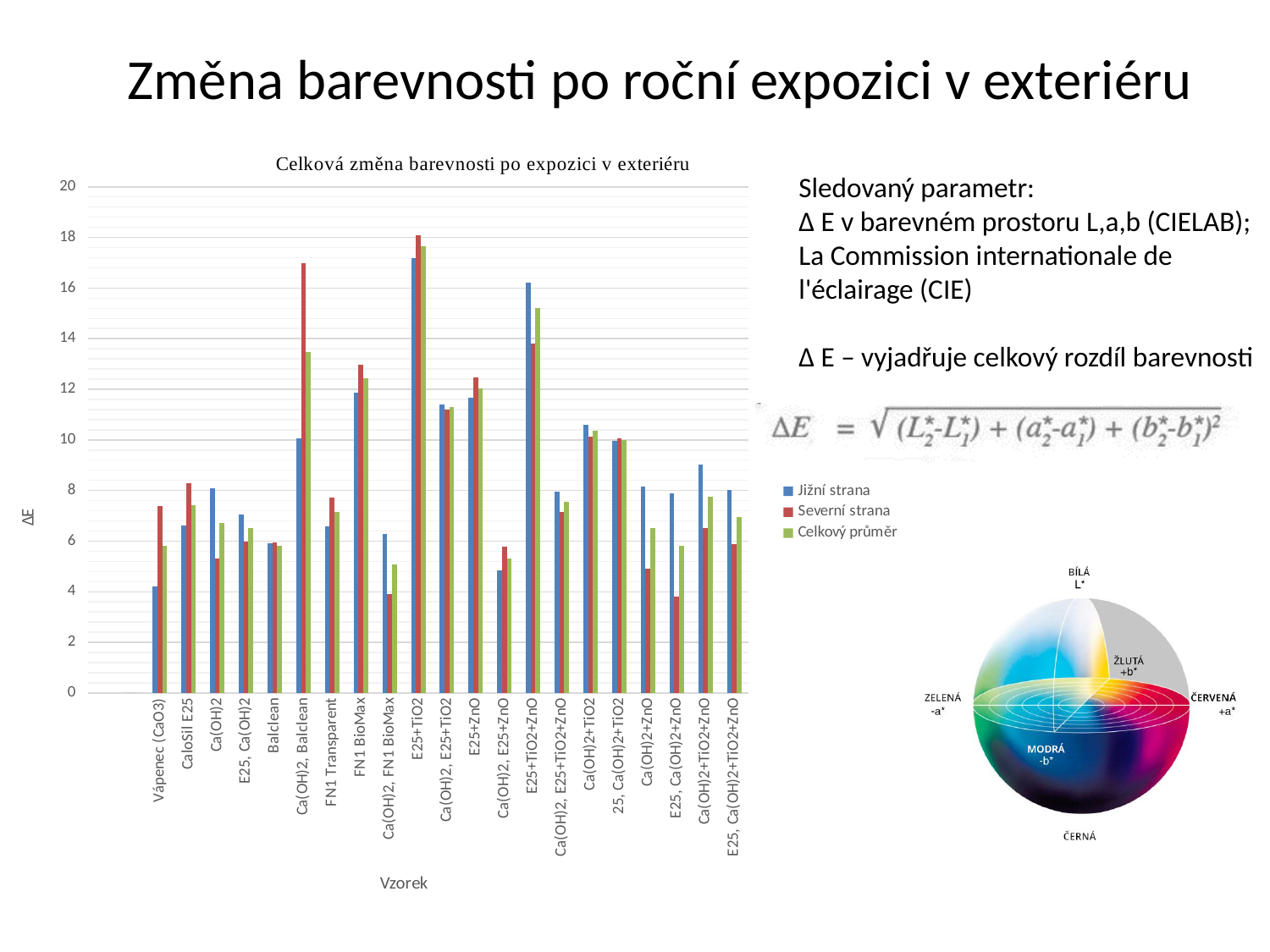
What is the title of the chart? Celková změna barevnosti po expozici v exteriéru For Ca(OH)2, Balclean, which series has the larger value: Jižní strana or Severní strana? Severní strana What kind of chart is shown on the slide? bar chart Which category has the highest value for the Severní strana series? E25+TiO2 Is the Severní strana value for Ca(OH)2, Balclean greater or less than 16? greater How many series does the chart legend list? 3 Which category has the lowest value for the Jižní strana series? Vápenec (CaO3) Is the Jižní strana value for FN1 BioMax greater or less than 10? greater For E25+TiO2+ZnO, which series has the larger value: Jižní strana or Severní strana? Jižní strana How many categories (samples) are shown on the x axis of the chart? 21 Which category has the highest value for the Jižní strana series? E25+TiO2 Is the Celkový průměr value for E25+TiO2+ZnO greater or less than 14? greater